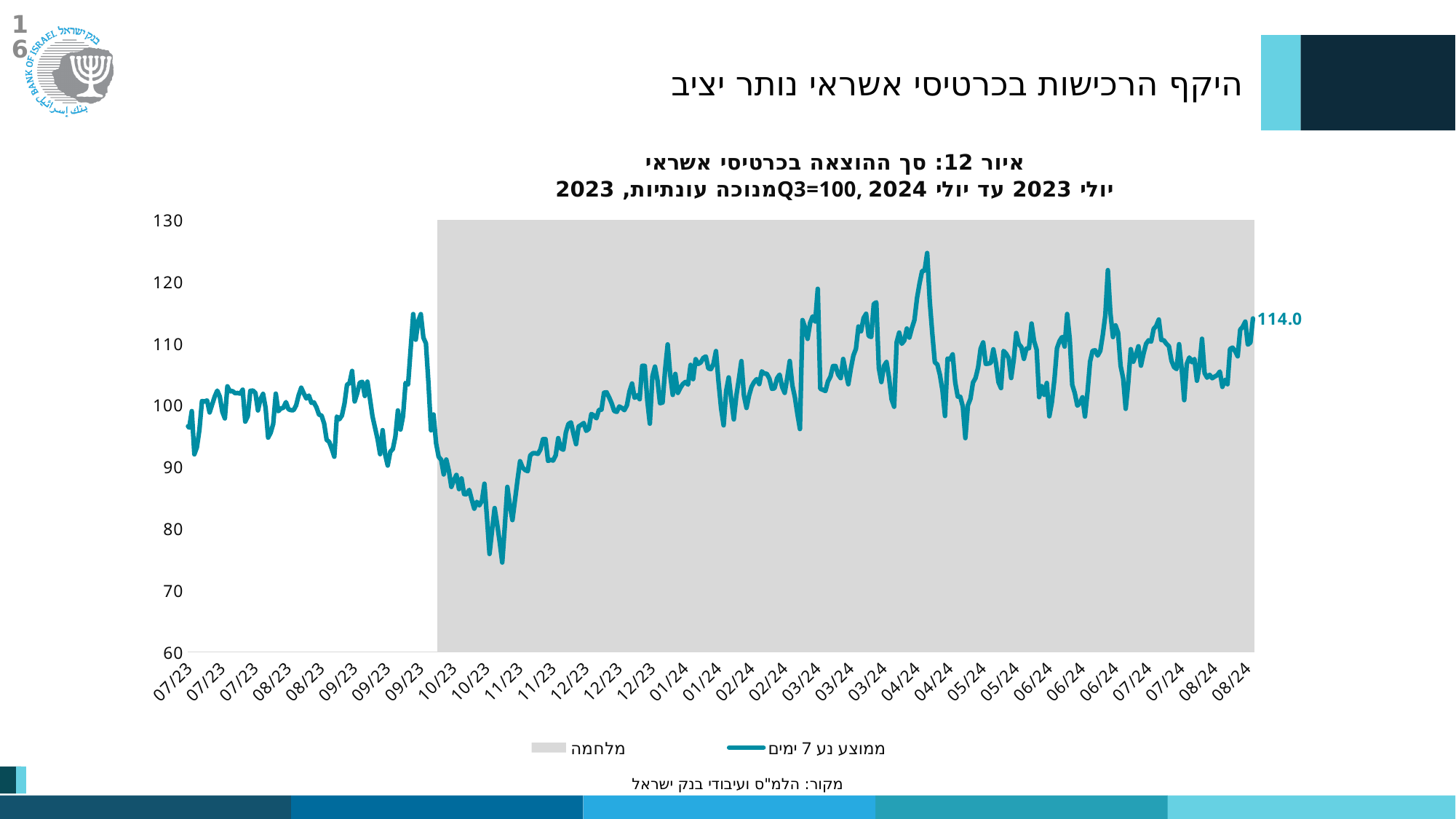
What is the lowest value shown on the y axis? 60 Is the peak of the line around 04/24 greater or less than 120? greater Is the value at the start of the series (07/23) higher or lower than the value at the end (08/24)? lower Is the lowest point of the line, reached in the shaded area in late 2023, greater or less than 80? less What kind of chart is shown on the slide? line chart Around which x-axis label does the line reach its highest value? 04/24 What is the value printed at the end of the line (08/24)? 114.0 How many entries does the legend list? 2 From the low point in late 2023 to 08/24, does the line generally rise or fall? rise What does the grey shaded area represent according to the legend? מלחמה Is the final value of the line (08/24) greater or less than 110? greater